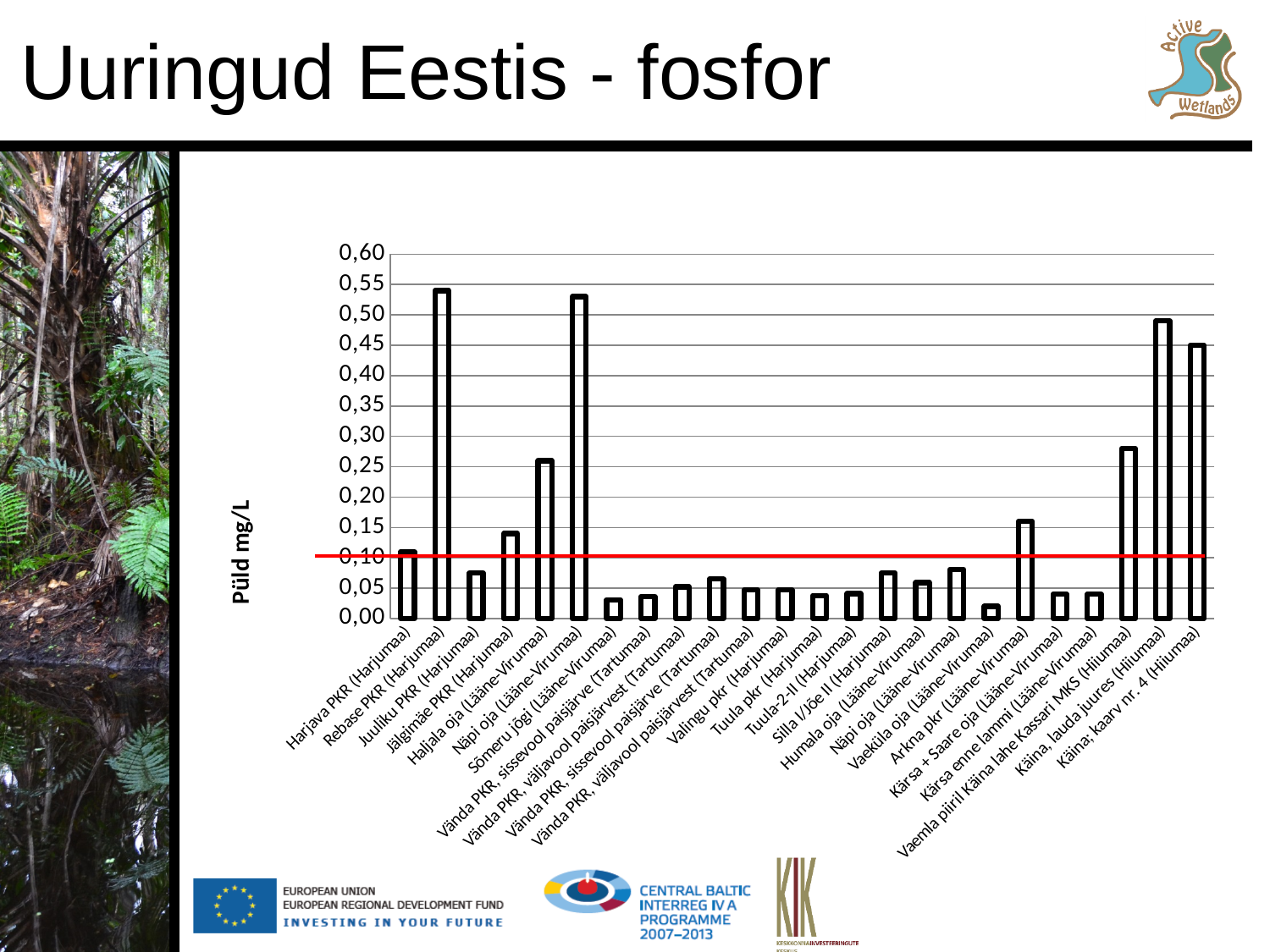
Is the value for Haljala oja (Lääne-Virumaa) greater or less than 0,20? greater Is the value for Käina, kaarv nr. 4 (Hiiumaa) greater or less than 0,40? greater Which has the larger value: Haljala oja (Lääne-Virumaa) or Arkna pkr (Lääne-Virumaa)? Haljala oja (Lääne-Virumaa) What is the label of the vertical axis? Püld mg/L Which has the larger value: Käina, lauda juures (Hiiumaa) or Vaemla piiril Käina lahe Kassari MKS (Hiiumaa)? Käina, lauda juures (Hiiumaa) How many bars (categories) are plotted in the chart? 24 What kind of chart is shown on the slide? bar chart Is the value for Arkna pkr (Lääne-Virumaa) greater or less than 0,10? greater At what value on the vertical axis is the red horizontal line drawn? 0,10 Which has the larger value: Rebase PKR (Harjumaa) or Juuliku PKR (Harjumaa)? Rebase PKR (Harjumaa)